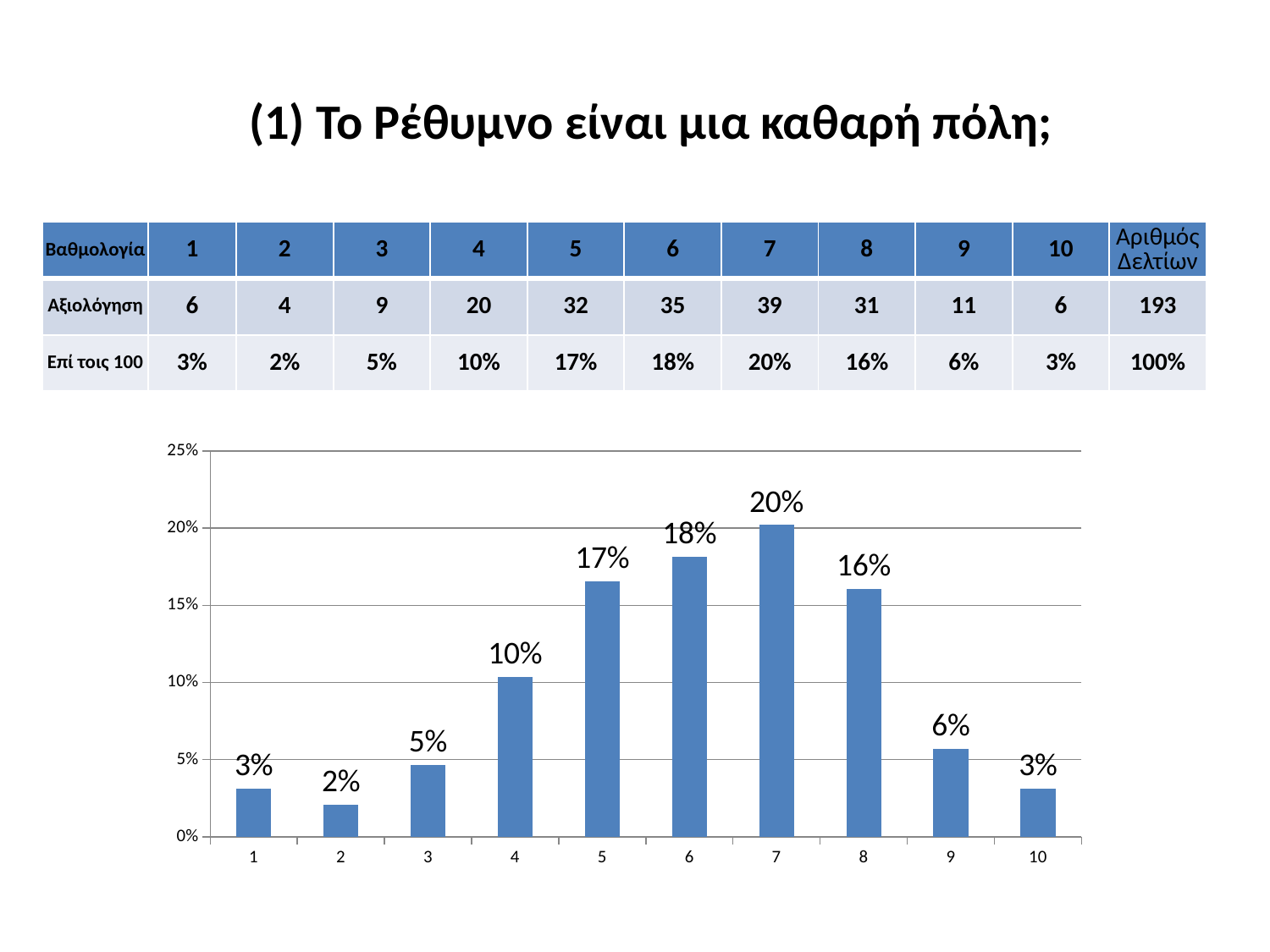
Is the value for category 8 in the bar chart greater or less than 15%? greater What kind of chart is shown on the slide? bar chart What is the highest value labelled on the y axis of the bar chart? 25% Which has a larger value in the bar chart, category 6 or category 9? 6 Do the values in the bar chart rise or fall from category 7 to category 10? fall Which category has the highest value in the bar chart? 7 Which category has the lowest value in the bar chart? 2 What is the difference between the values for category 7 and category 8 in the bar chart? 4% How many categories are shown on the x axis of the bar chart? 10 What is the difference between the values for category 5 and category 3 in the bar chart? 12% What is the value shown for category 4 in the bar chart? 10% What is the value shown for category 7 in the bar chart? 20%